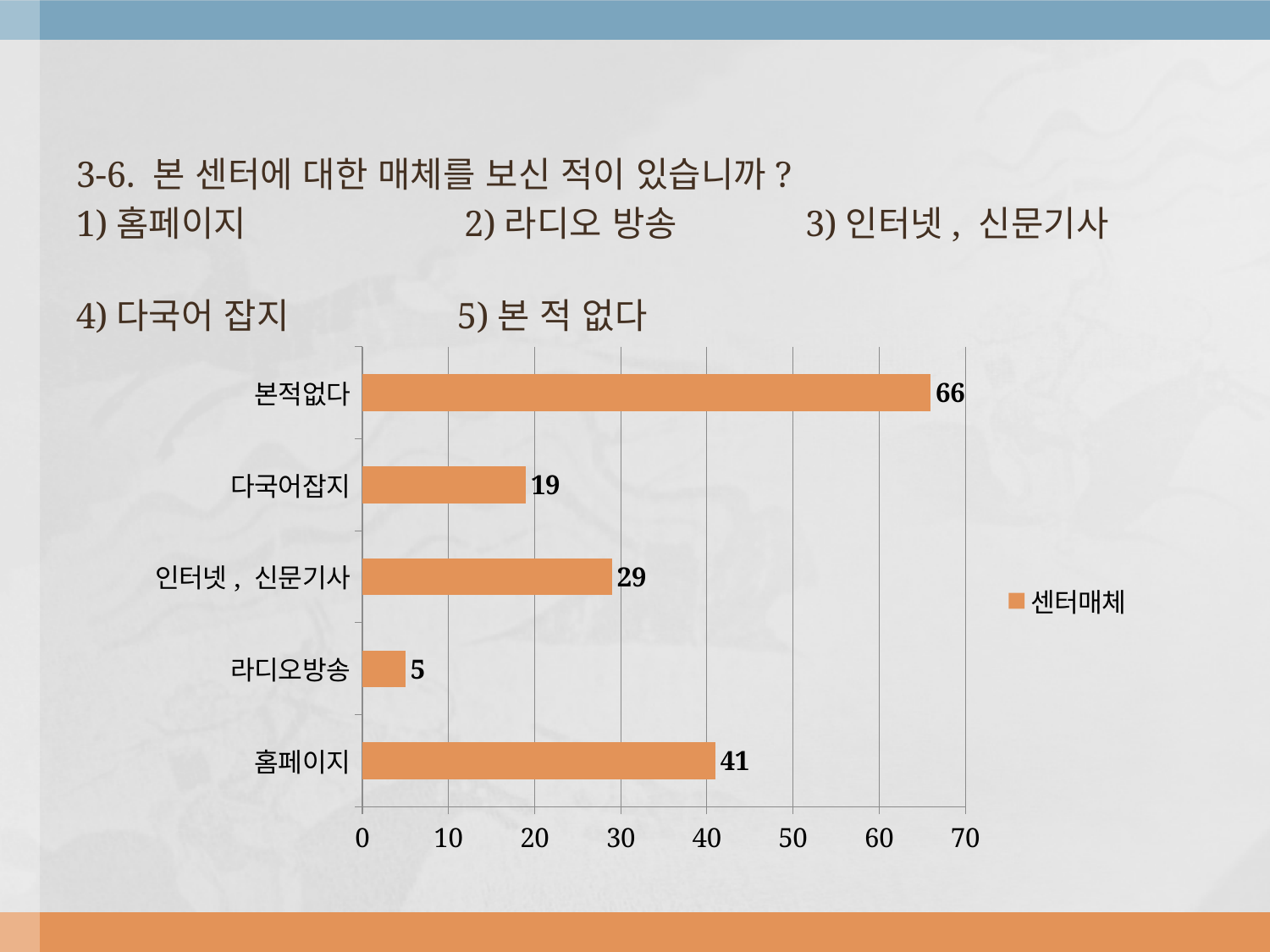
Which is larger, the value for 다국어잡지 or the value for 인터넷 , 신문기사? 인터넷 , 신문기사 What is the name of the series shown in the legend? 센터매체 What is the value for 라디오방송? 5 Which category has the lowest value? 라디오방송 What is the value for 인터넷 , 신문기사? 29 What is the value for 홈페이지? 41 What is the difference between the values for 본적없다 and 홈페이지? 25 Which category has the highest value? 본적없다 What kind of chart is shown on the slide? bar chart What is the value for 본적없다? 66 How many categories are shown in the chart? 5 How many series does the legend list? 1